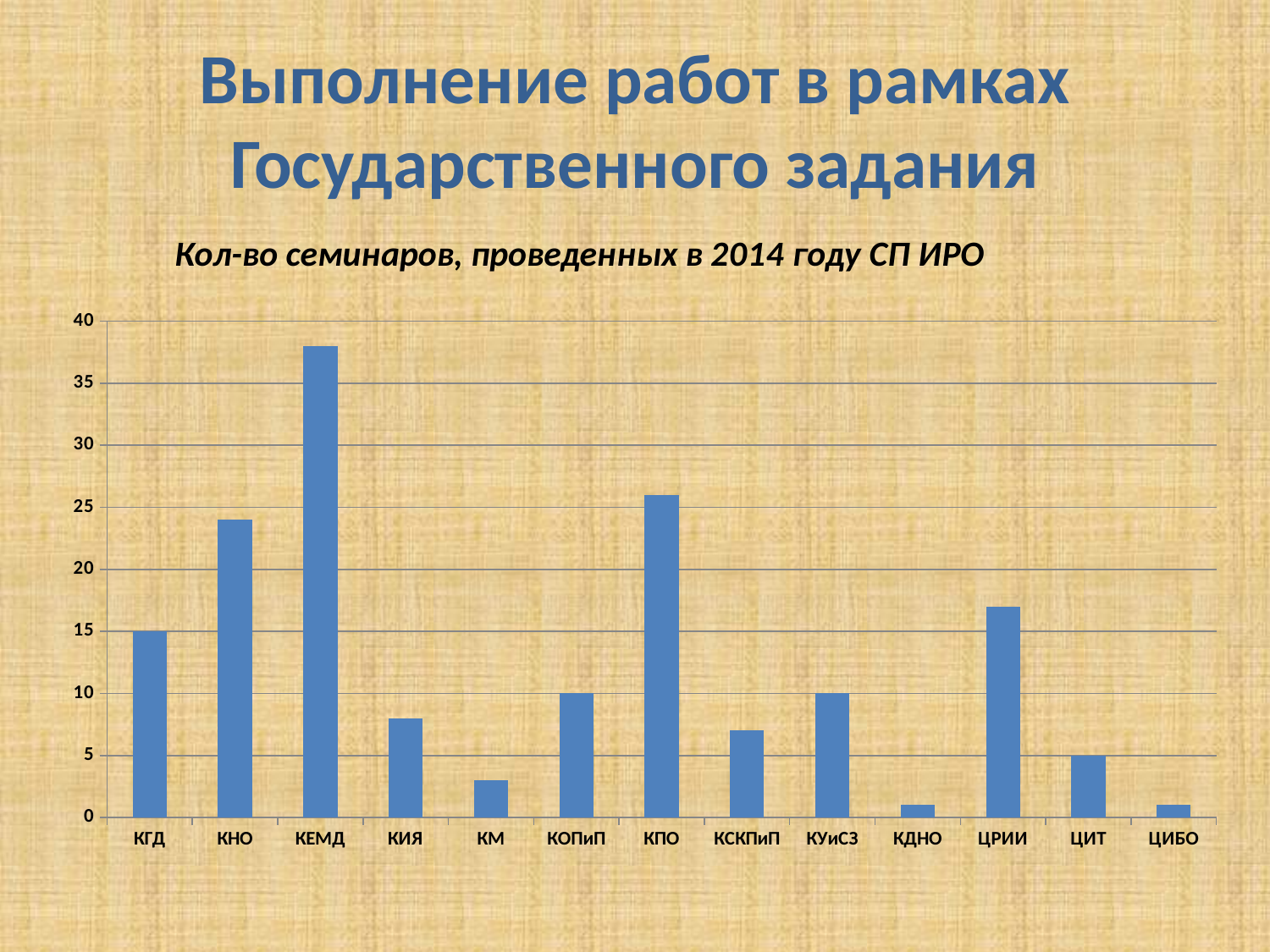
What is the title of the chart? Кол-во семинаров, проведенных в 2014 году СП ИРО What type of chart is shown on the slide? bar chart Is the value for ЦРИИ greater or less than 15? greater How many categories are shown on the x axis of the chart? 13 What is the value for КГД? 15 Which category has the highest value in the chart? КЕМД What is the value for ЦИТ? 5 What is the difference between the values for КГД and ЦИТ? 10 Is the value for КЕМД greater or less than 35? greater Is the value for КИЯ greater or less than 10? less What is the value for КОПиП? 10 Which is larger, the value for КНО or the value for ЦРИИ? КНО